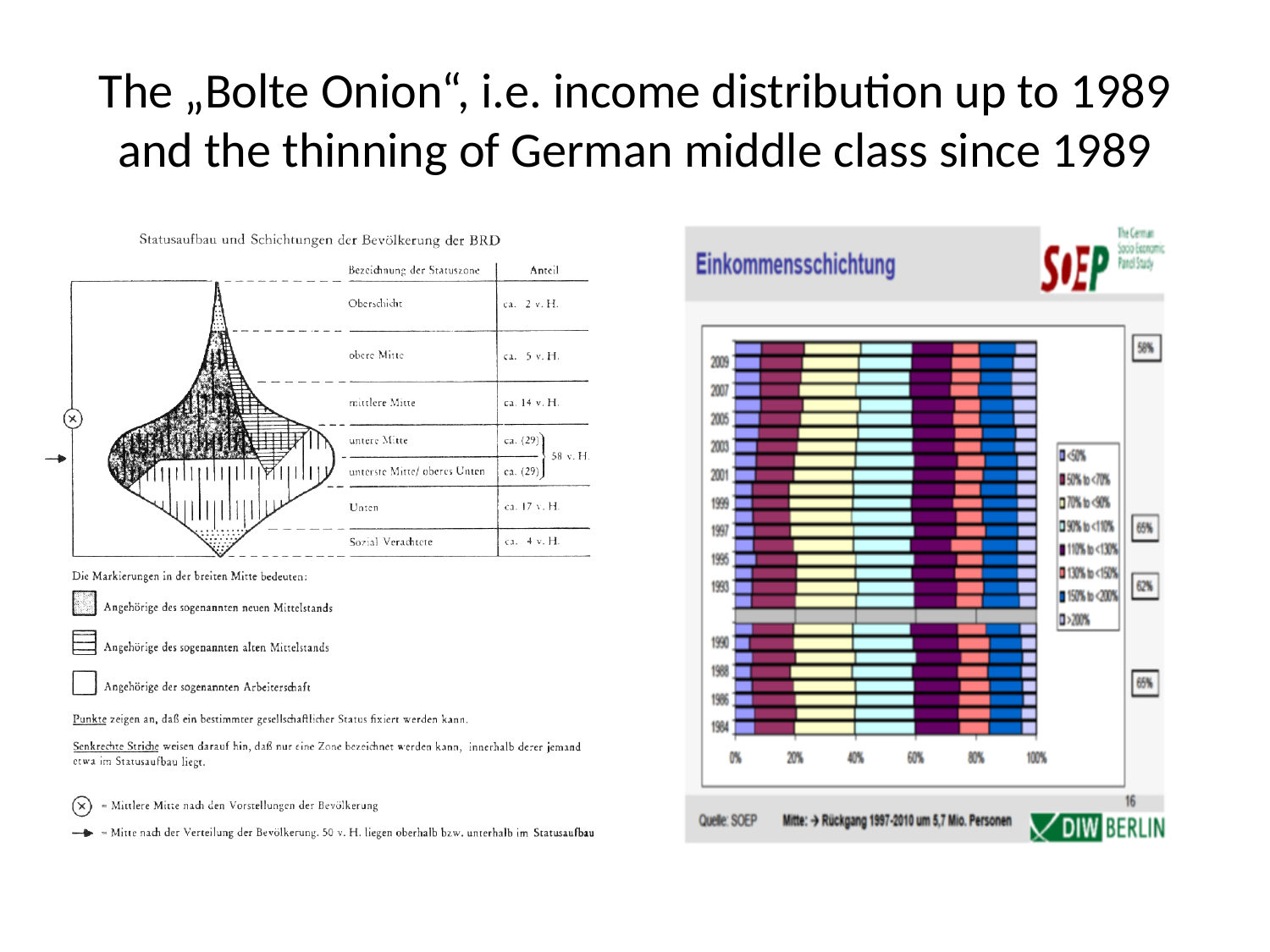
In the 'Einkommensschichtung' chart, what percentage is annotated in the box next to the 2009 bar? 58% What source is cited below the 'Einkommensschichtung' chart? SOEP How many years (bars) are shown in the 'Einkommensschichtung' chart? 13 How many series does the legend of the 'Einkommensschichtung' chart list? 8 In the 'Einkommensschichtung' chart, what is the latest year shown on the vertical axis? 2009 In the left 'Statusaufbau' diagram, what share (Anteil) is given for 'Unten'? ca. 17 v. H. What is the first legend entry of the 'Einkommensschichtung' chart? <50% In the 'Einkommensschichtung' chart, what is the highest tick value on the horizontal axis? 100% In the left 'Statusaufbau' diagram, what share (Anteil) is given for the Oberschicht? ca. 2 v. H. In the 'Einkommensschichtung' chart, what is the earliest year shown on the vertical axis? 1984 What kind of chart is the 'Einkommensschichtung' chart on the right of the slide? Stacked bar chart In the left 'Statusaufbau' diagram, what combined share is given for 'untere Mitte' and 'unterste Mitte/oberes Unten' together? 58 v. H.